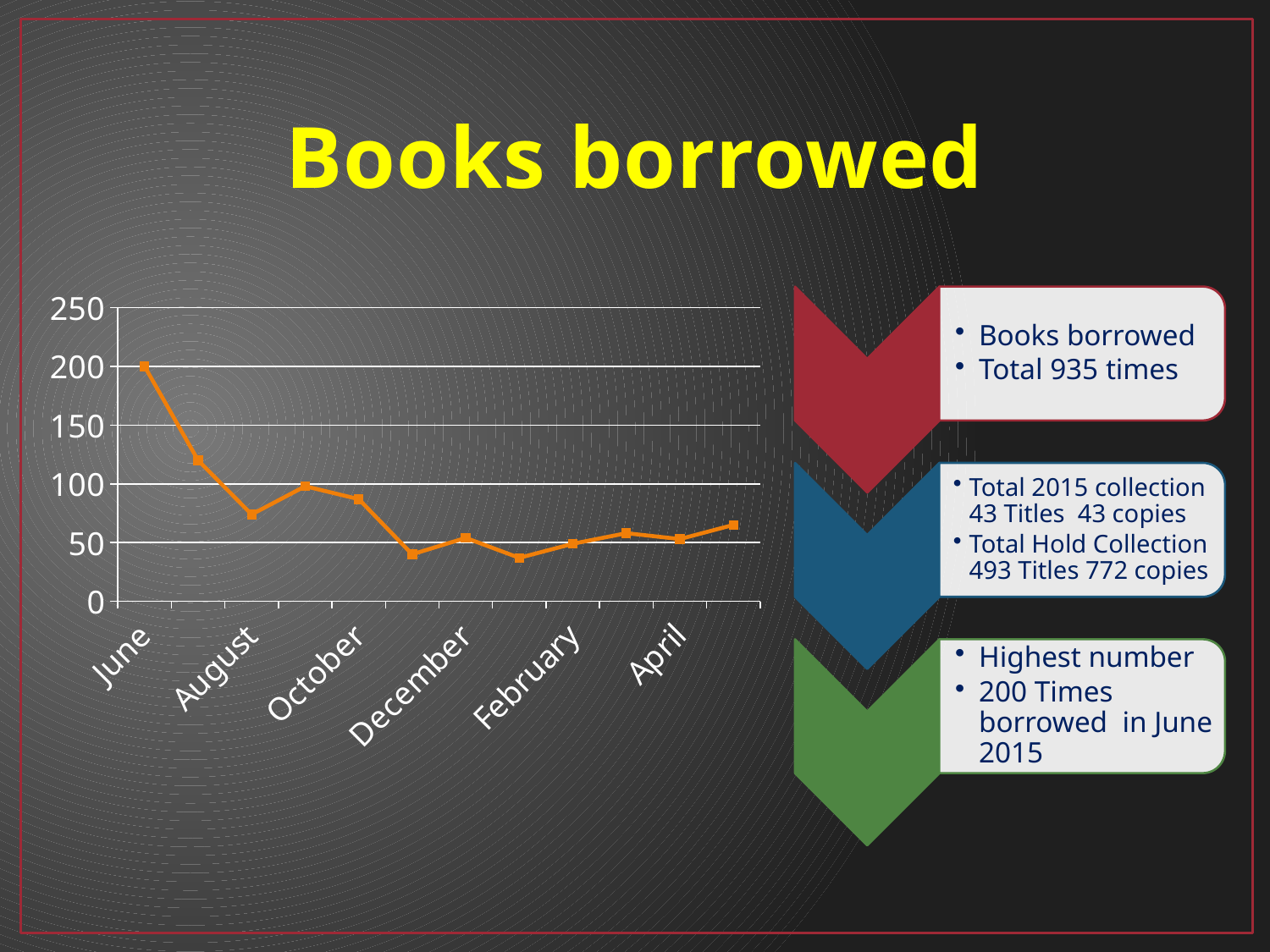
Which month has the highest number of books borrowed? June Which is larger, the value for October or the value for December? October Which is larger, the value for June or the value for August? June Is the value for August greater or less than 100? less Is the value for December greater or less than 100? less What is the value for June? 200 Do the values generally rise or fall from June to December? fall What is the title of the slide containing the chart? Books borrowed What kind of chart is shown on the slide? line chart Is the value for April greater or less than 100? less How many month labels are shown on the x axis? 6